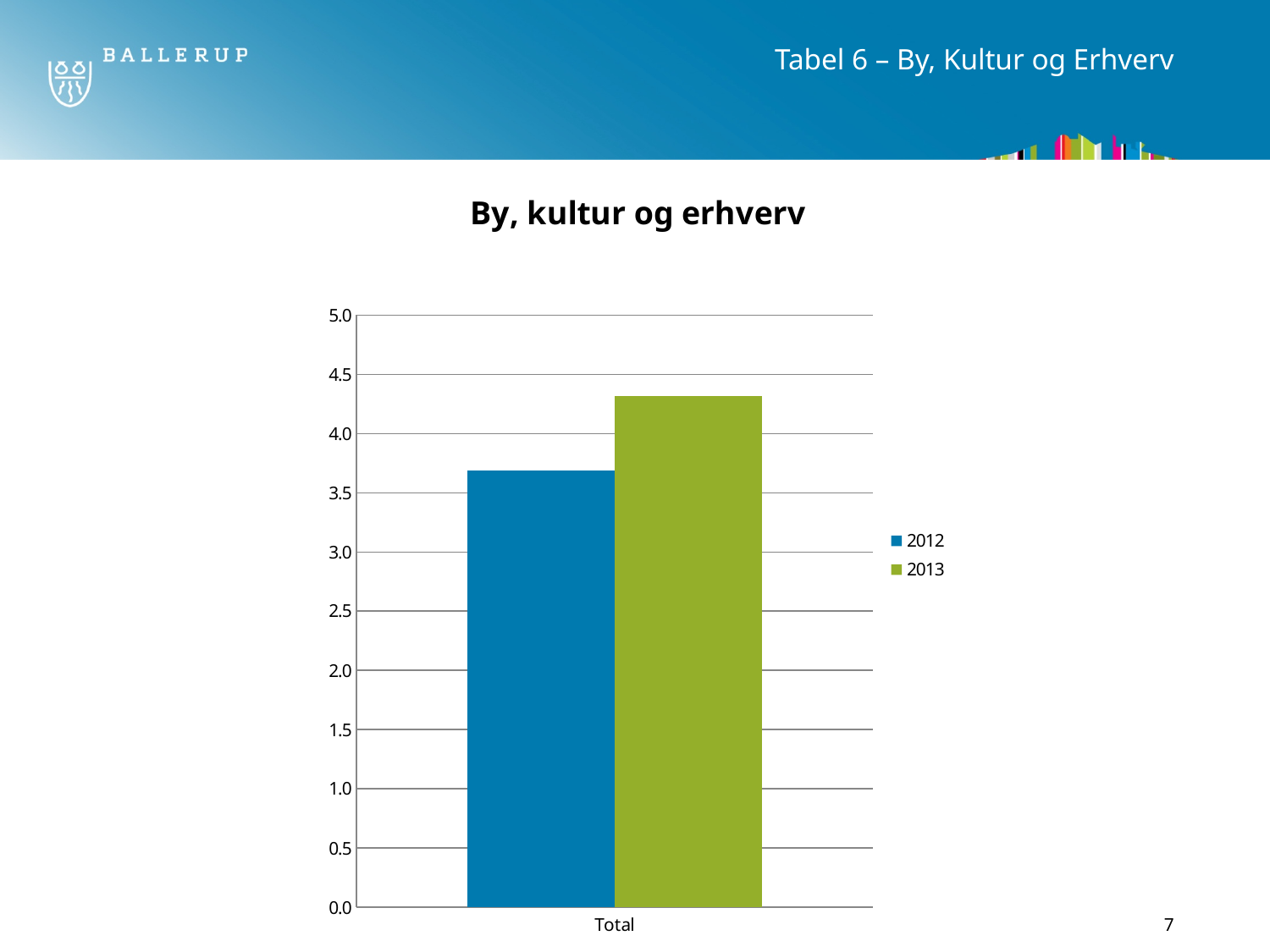
Is the value for 2012 in the Total category greater or less than 4.0? less Is the value for 2012 in the Total category greater or less than 3.5? greater Which series has the higher value for Total, 2012 or 2013? 2013 Which series is shown in green in the legend? 2013 Is the value for 2013 in the Total category greater or less than 4.5? less What is the label of the single category on the x axis? Total How many series does the legend list? 2 How many categories are shown on the x axis? 1 What kind of chart is shown on the slide? bar chart Which series has the lowest bar for Total? 2012 What is the title of the chart? By, kultur og erhverv